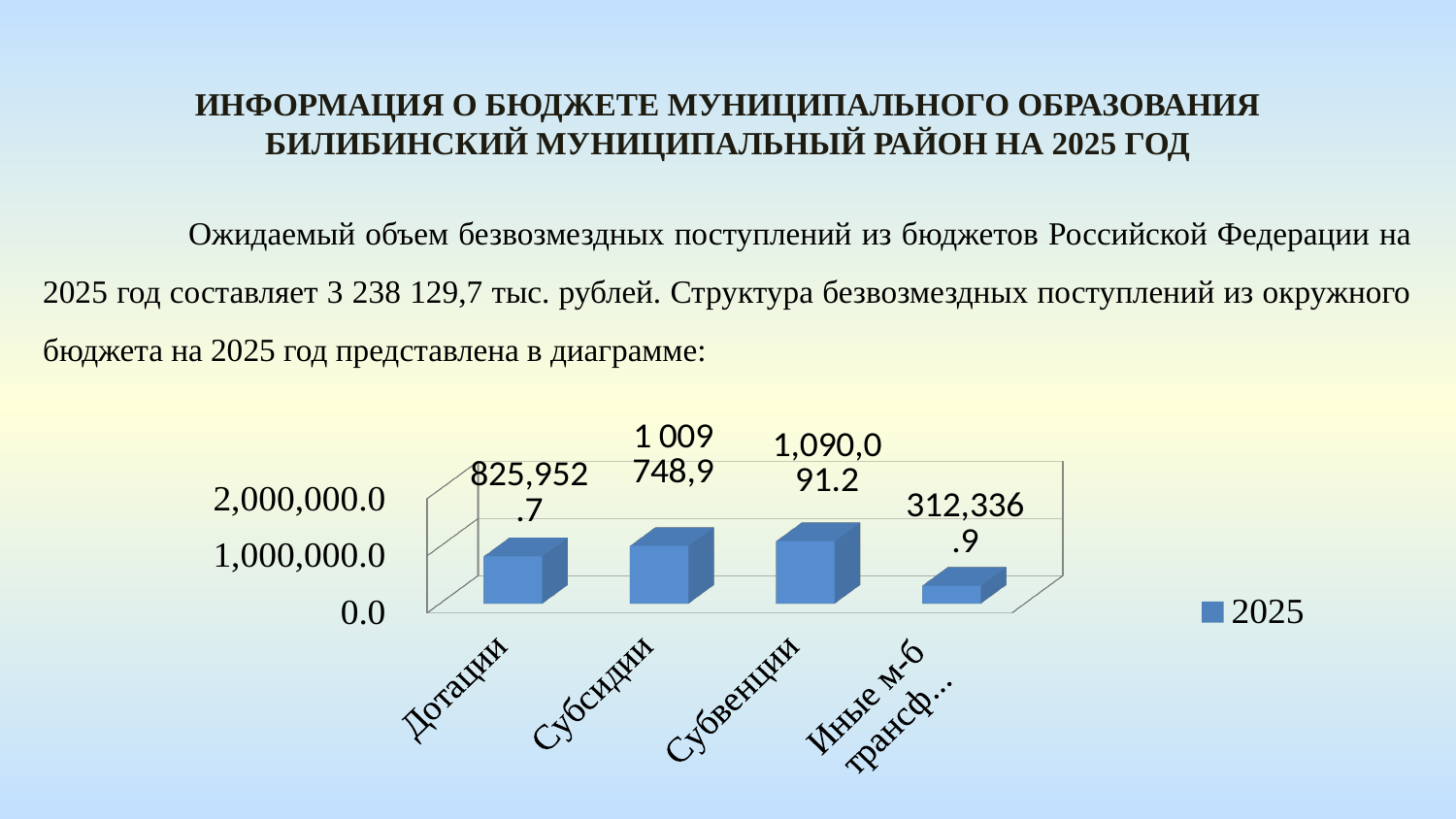
Is the value for Дотации greater or less than 1,000,000.0? less What is the value for Субвенции? 1,090,091.2 What kind of chart is shown on the slide? bar chart Which category has the highest value? Субвенции What is the value for Дотации? 825,952.7 Which category has the lowest value? Иные м-б трансф... Is the value for Субвенции greater or less than 1,000,000.0? greater Which is larger, the value for Субсидии or the value for Дотации? Субсидии How many categories are shown on the chart? 4 How many series does the legend list? 1 What is the value for Субсидии? 1 009 748,9 What is the difference between the values for Субвенции and Дотации? 264,138.5